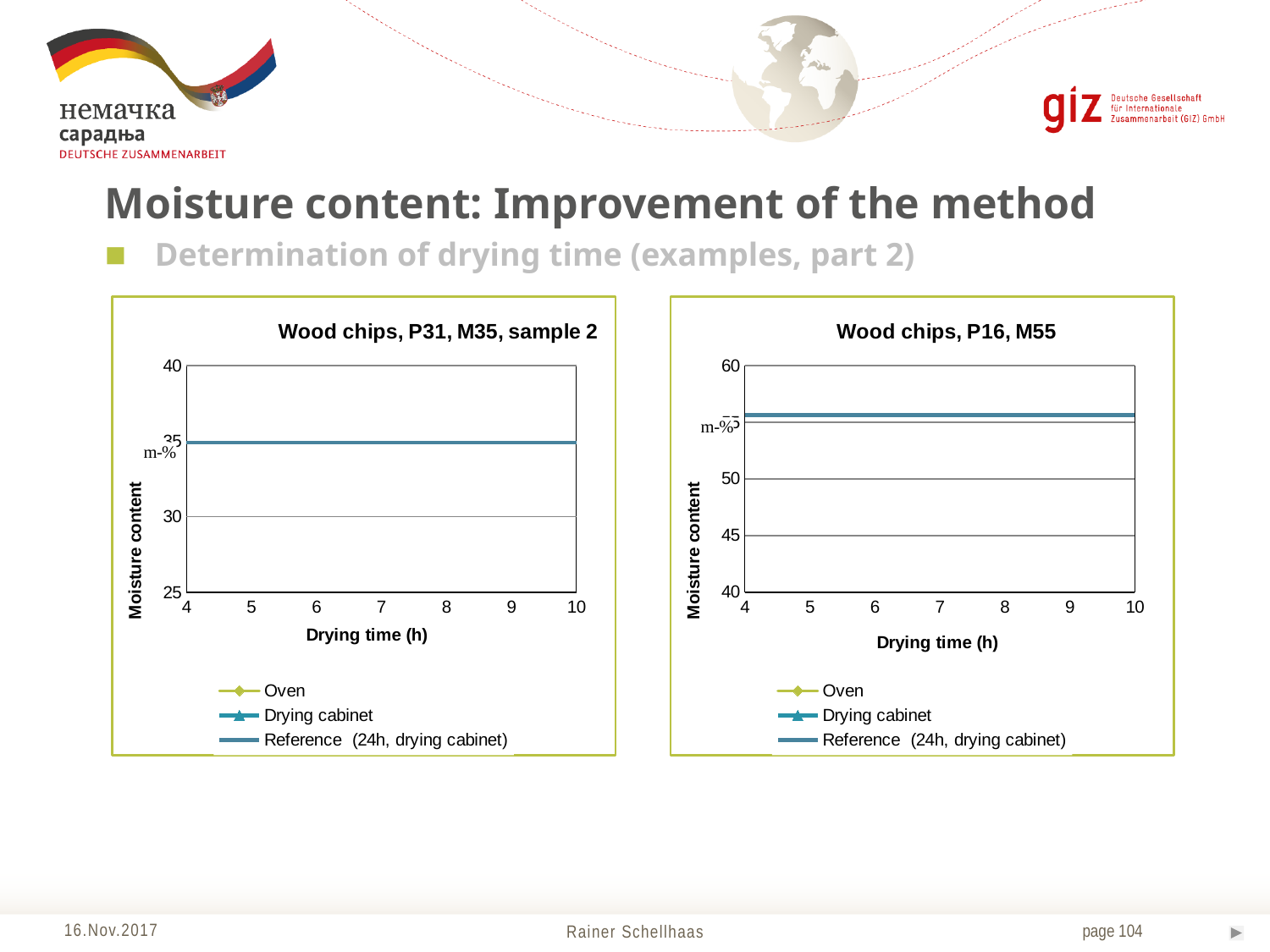
In the right chart (Wood chips, P16, M55), does the Reference (24h, drying cabinet) line rise, fall, or stay flat as drying time increases? stays flat In the right chart (Wood chips, P16, M55), is the Reference (24h, drying cabinet) line greater or less than 50? greater What is the x-axis label of the left chart (Wood chips, P31, M35, sample 2)? Drying time (h) In the right chart (Wood chips, P16, M55), how many series does the legend list? 3 What kind of chart is the left chart titled "Wood chips, P31, M35, sample 2"? line chart In the left chart (Wood chips, P31, M35, sample 2), is the Reference (24h, drying cabinet) line greater or less than 30? greater What is the title of the right chart on the slide? Wood chips, P16, M55 In the right chart (Wood chips, P16, M55), is the Reference (24h, drying cabinet) line greater or less than 60? less What kind of chart is the right chart titled "Wood chips, P16, M55"? line chart In the left chart (Wood chips, P31, M35, sample 2), how many series does the legend list? 3 In the left chart (Wood chips, P31, M35, sample 2), does the Reference (24h, drying cabinet) line rise, fall, or stay flat as drying time increases? stays flat